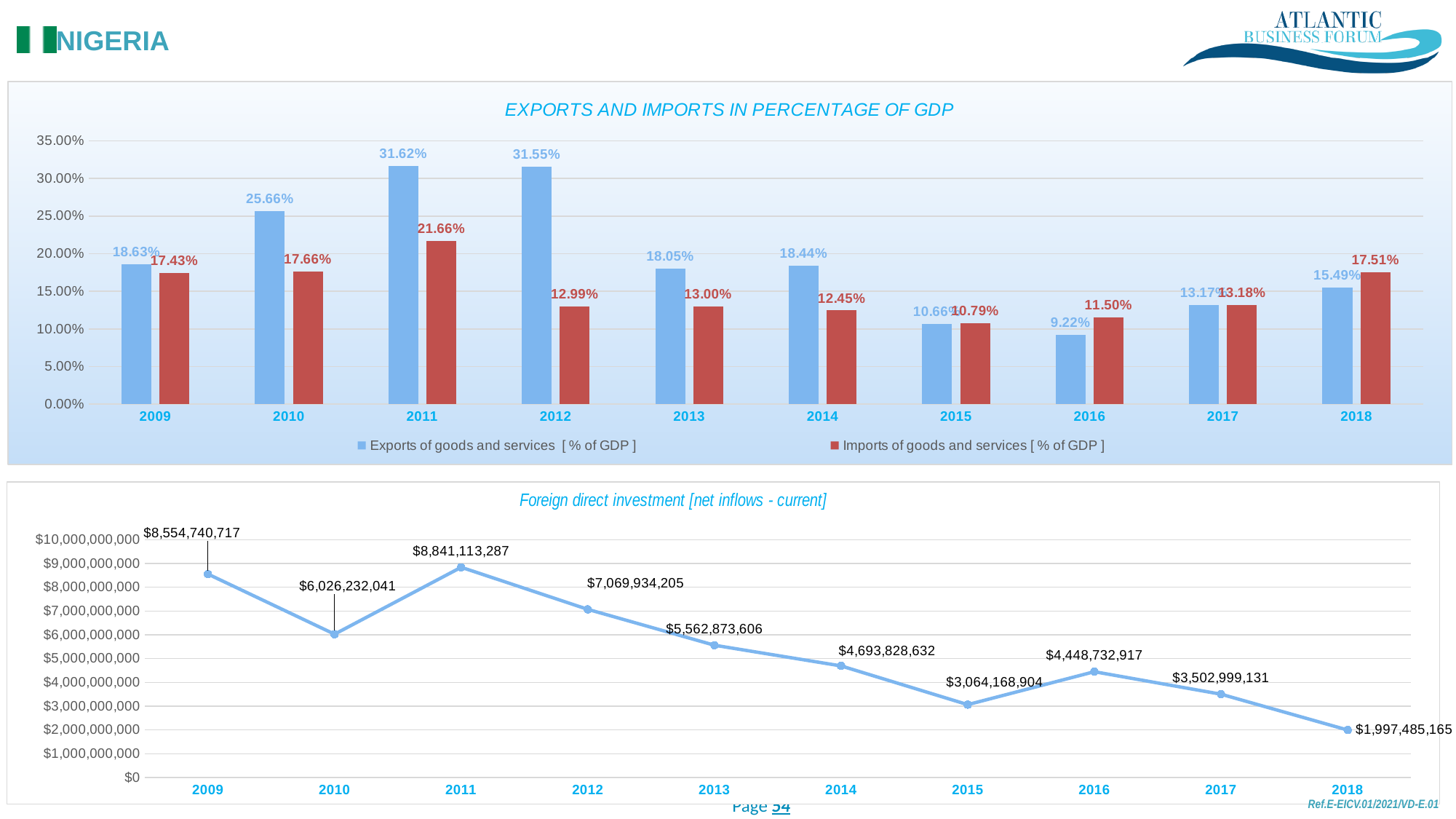
In the 'EXPORTS AND IMPORTS IN PERCENTAGE OF GDP' chart, what is the value of exports of goods and services in 2011? 31.62% How many series does the legend of the 'EXPORTS AND IMPORTS IN PERCENTAGE OF GDP' chart list? 2 In the 'EXPORTS AND IMPORTS IN PERCENTAGE OF GDP' chart, which year has the highest imports value? 2011 In the 'Foreign direct investment [net inflows - current]' chart, which year has the highest value? 2011 In the 'EXPORTS AND IMPORTS IN PERCENTAGE OF GDP' chart, what is the value of imports of goods and services in 2018? 17.51% In the 'Foreign direct investment [net inflows - current]' chart, what is the difference between the 2009 and 2010 values? $2,528,508,676 In the 'EXPORTS AND IMPORTS IN PERCENTAGE OF GDP' chart, which year has the lowest exports value? 2016 How many years are plotted in the 'Foreign direct investment [net inflows - current]' chart? 10 In the 'EXPORTS AND IMPORTS IN PERCENTAGE OF GDP' chart, what is the difference between exports and imports in 2011? 9.96% What kind of chart is the 'EXPORTS AND IMPORTS IN PERCENTAGE OF GDP' chart? Bar chart In the 'EXPORTS AND IMPORTS IN PERCENTAGE OF GDP' chart, which is larger in 2012, exports or imports? Exports In the 'Foreign direct investment [net inflows - current]' chart, what is the value for 2015? $3,064,168,904